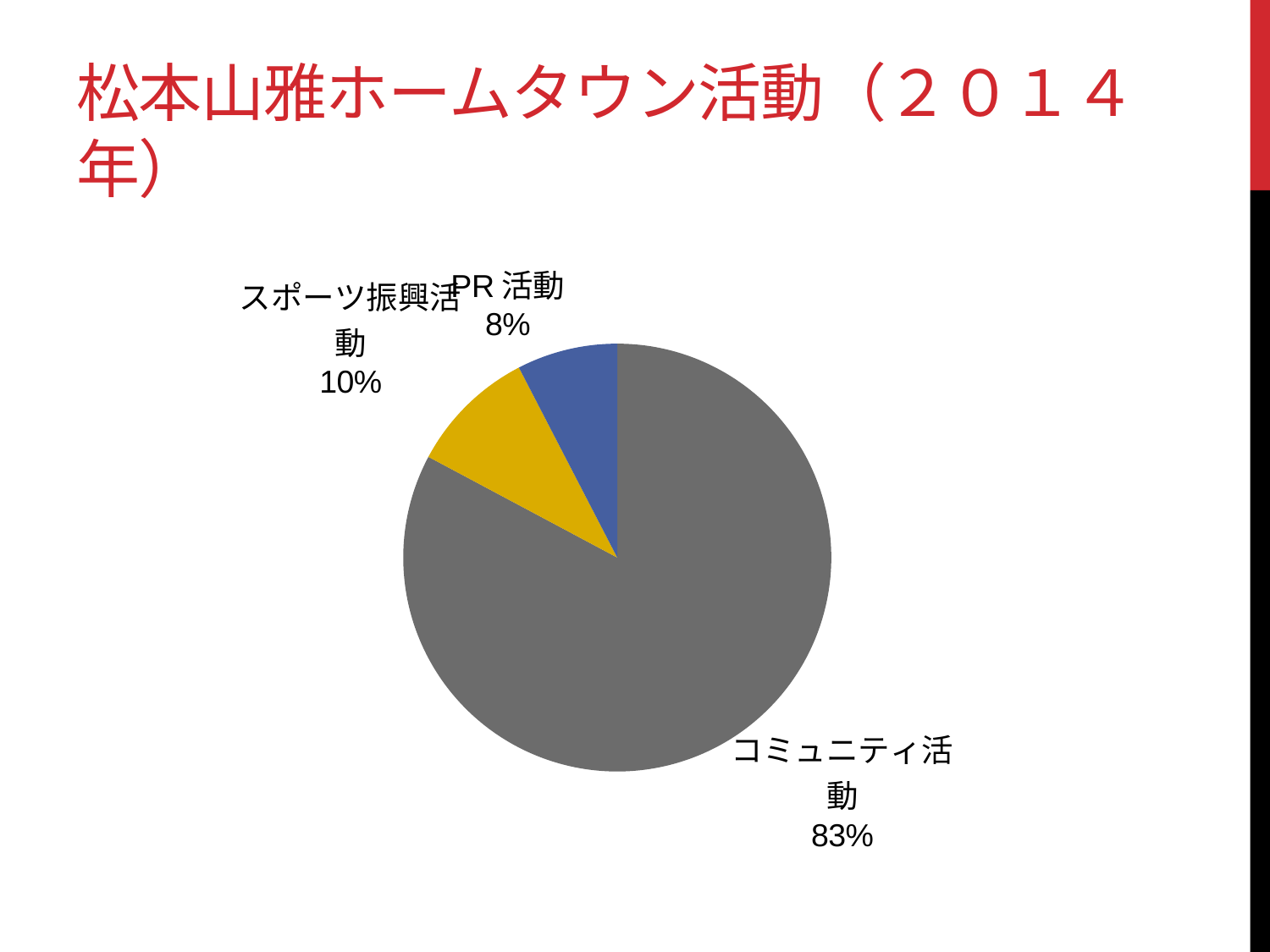
What share of the pie does PR活動 have? 8% What is the title of the slide? 松本山雅ホームタウン活動（２０１４年） What share of the pie does スポーツ振興活動 have? 10% What colour is the slice for コミュニティ活動? Grey What is the difference in percentage points between コミュニティ活動 and スポーツ振興活動? 73 What share of the pie does コミュニティ活動 have? 83% How many categories are shown in the pie chart? 3 Which category has the smallest slice of the pie? PR活動 Which category has the largest slice of the pie? コミュニティ活動 What is the difference in percentage points between スポーツ振興活動 and PR活動? 2 Which is larger, the slice for スポーツ振興活動 or the slice for PR活動? スポーツ振興活動 What kind of chart is shown on the slide? Pie chart